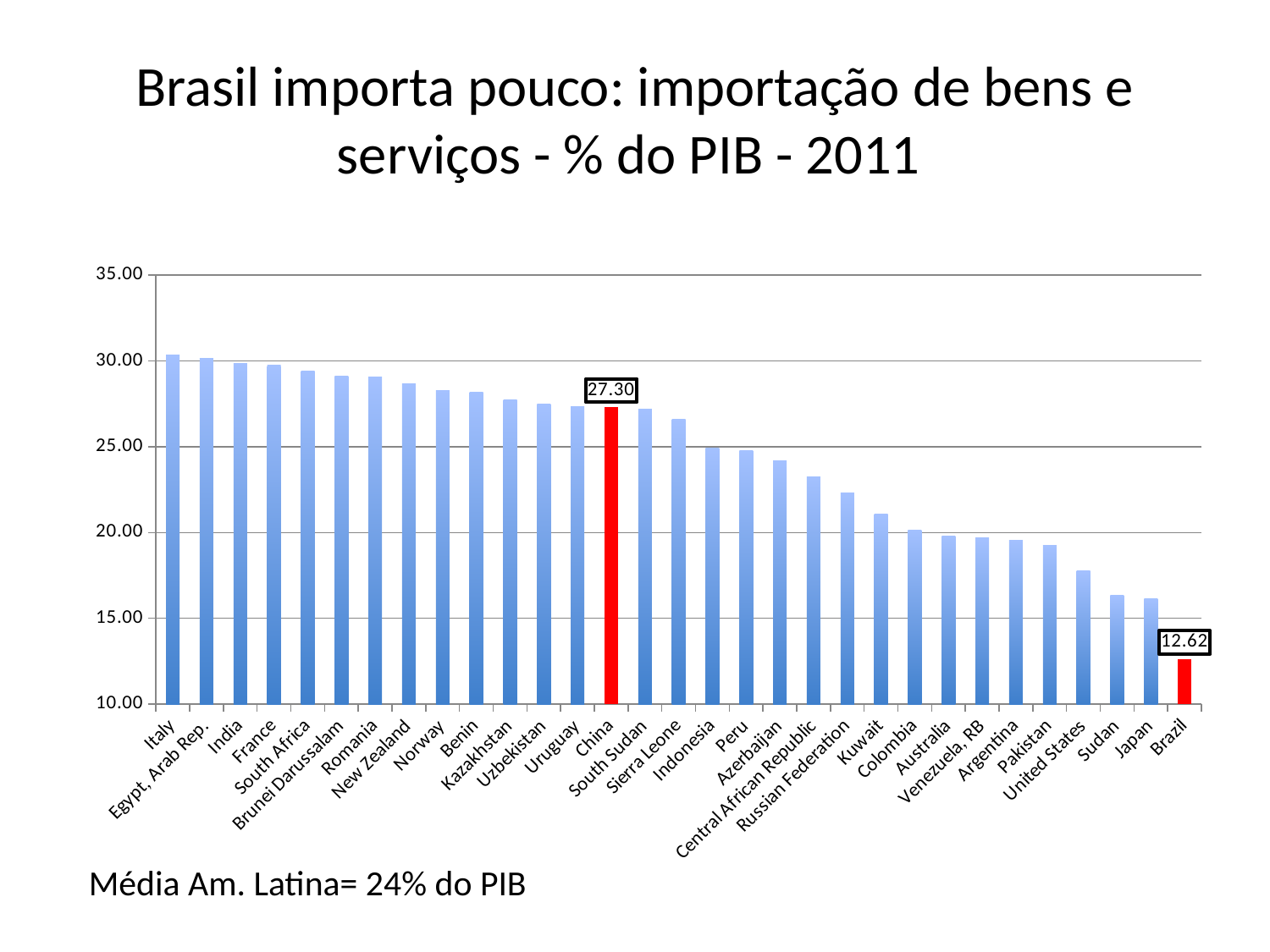
Is the value for Japan greater or less than 20.00? less What is the value shown for Brazil? 12.62 Which has the larger value, Italy or Japan? Italy What is the difference between the values for China and Brazil? 14.68 What is the value shown for China? 27.30 What kind of chart is shown on the slide? bar chart Which country has the lowest value in the chart? Brazil Which country has the highest value in the chart? Italy How many countries are shown in the chart? 31 Is the value for Russian Federation greater or less than 25.00? less Is the value for Norway greater or less than 25.00? greater Do the values rise or fall moving from left to right along the x axis? fall